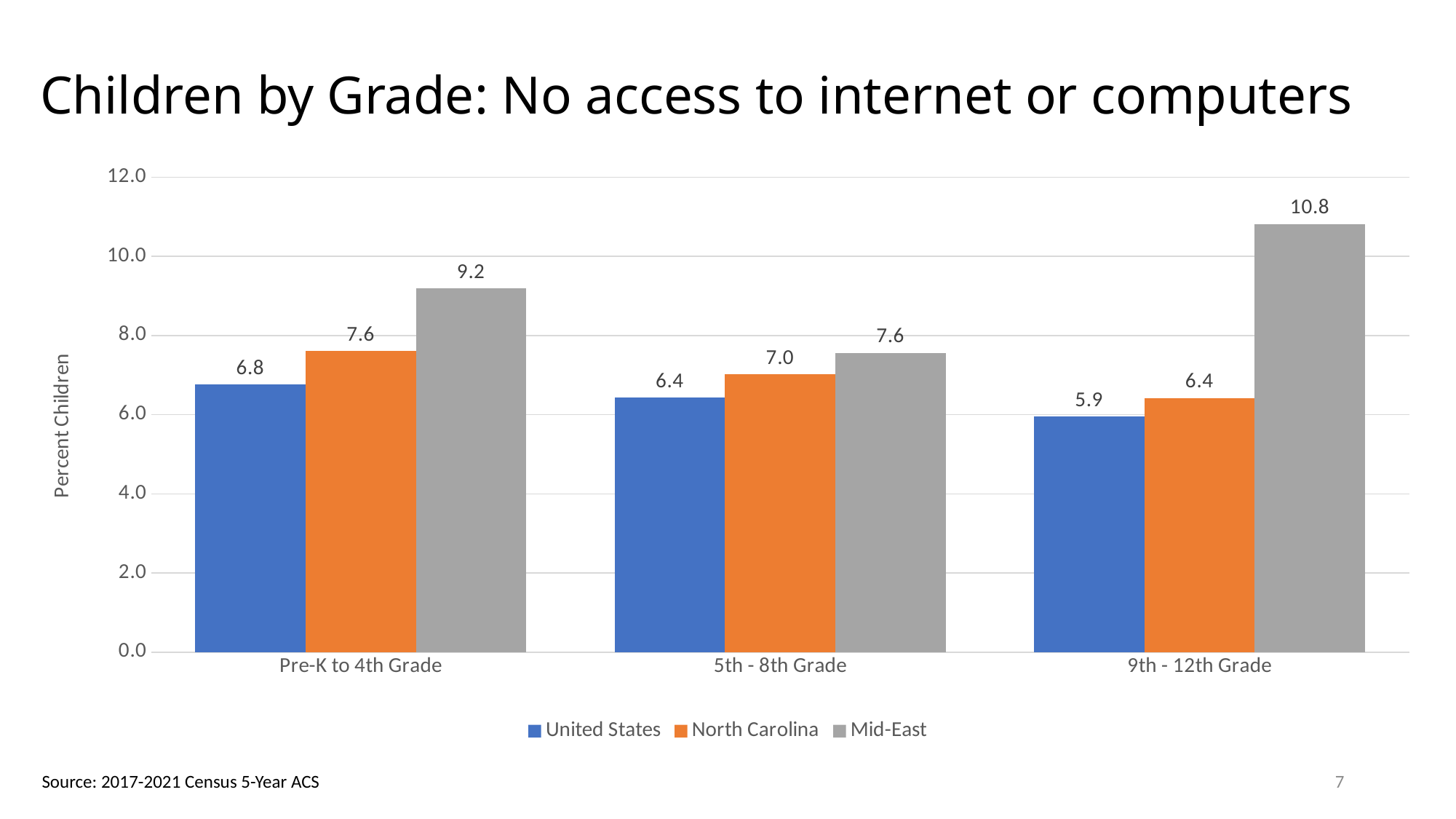
Is the Mid-East value for 9th - 12th Grade greater or less than 10.0? greater What is the value for United States in the Pre-K to 4th Grade category? 6.8 How many grade categories are shown on the x axis? 3 Which is larger in the Pre-K to 4th Grade category: North Carolina or Mid-East? Mid-East Do the United States values rise or fall from Pre-K to 4th Grade to 9th - 12th Grade? fall What is the value for Mid-East in the 9th - 12th Grade category? 10.8 What kind of chart is shown on the slide? bar chart How many series does the legend list? 3 What is the difference between the Mid-East and United States values for 9th - 12th Grade? 4.9 What is the value for North Carolina in the 5th - 8th Grade category? 7.0 Which grade category has the highest Mid-East value? 9th - 12th Grade Which grade category has the lowest United States value? 9th - 12th Grade